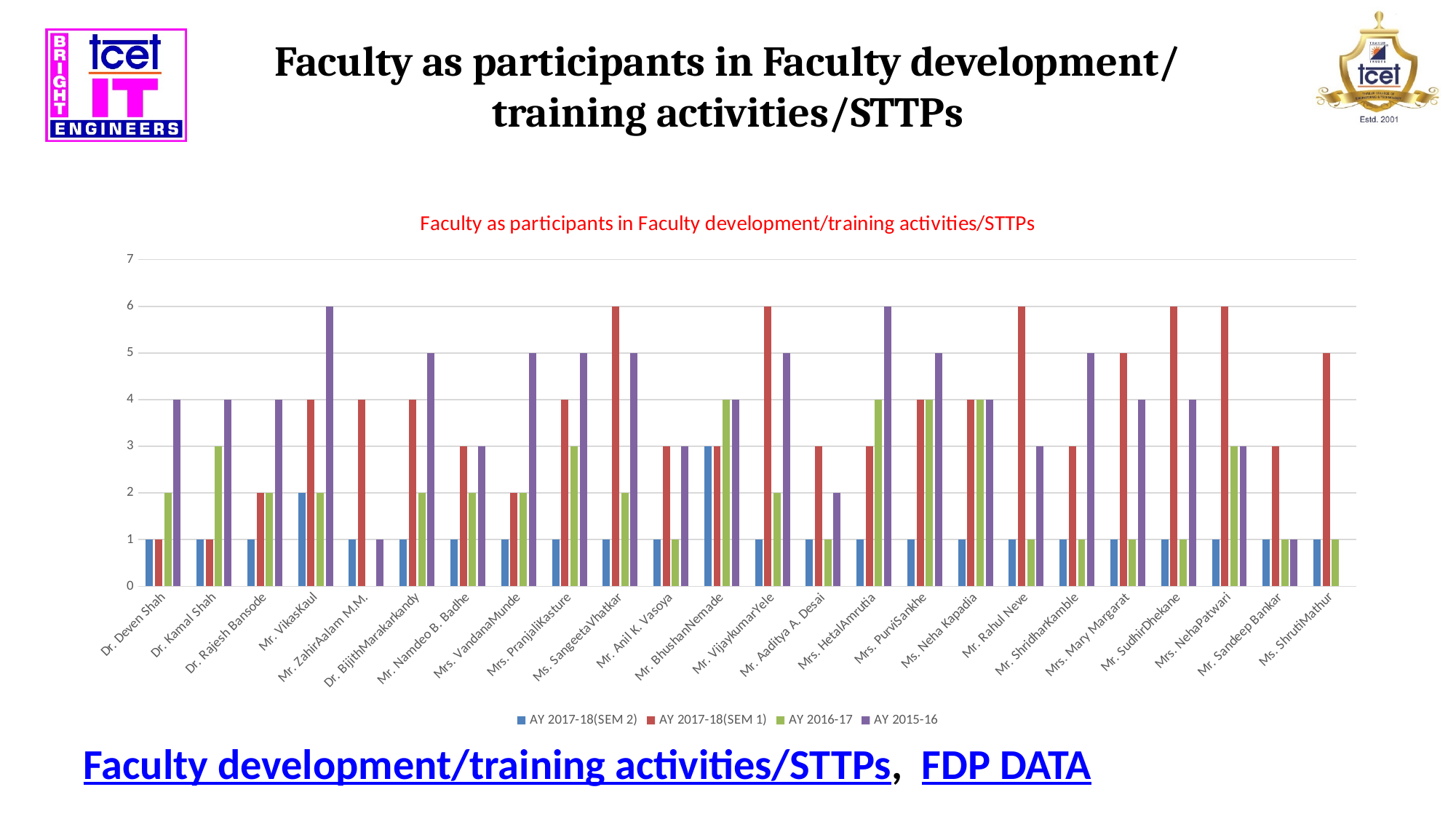
What kind of chart is shown on the slide? bar chart How many faculty members (categories) are shown on the x axis? 24 Which is larger for Mr. Rahul Neve: the AY 2017-18(SEM 1) value or the AY 2015-16 value? AY 2017-18(SEM 1) What is the AY 2017-18(SEM 1) value for Ms. SangeetaVhatkar? 6 What is the difference between the AY 2015-16 and AY 2017-18(SEM 2) values for Dr. Deven Shah? 3 What is the AY 2016-17 value for Dr. Kamal Shah? 3 Which faculty member has the highest AY 2017-18(SEM 2) value? Mr. BhushanNemade What is the AY 2017-18(SEM 2) value for Mr. BhushanNemade? 3 How many series does the legend list? 4 What is the title of the chart? Faculty as participants in Faculty development/training activities/STTPs What is the AY 2015-16 value for Mr. VikasKaul? 6 Is the AY 2015-16 value for Mrs. HetalAmrutia greater or less than 4? greater